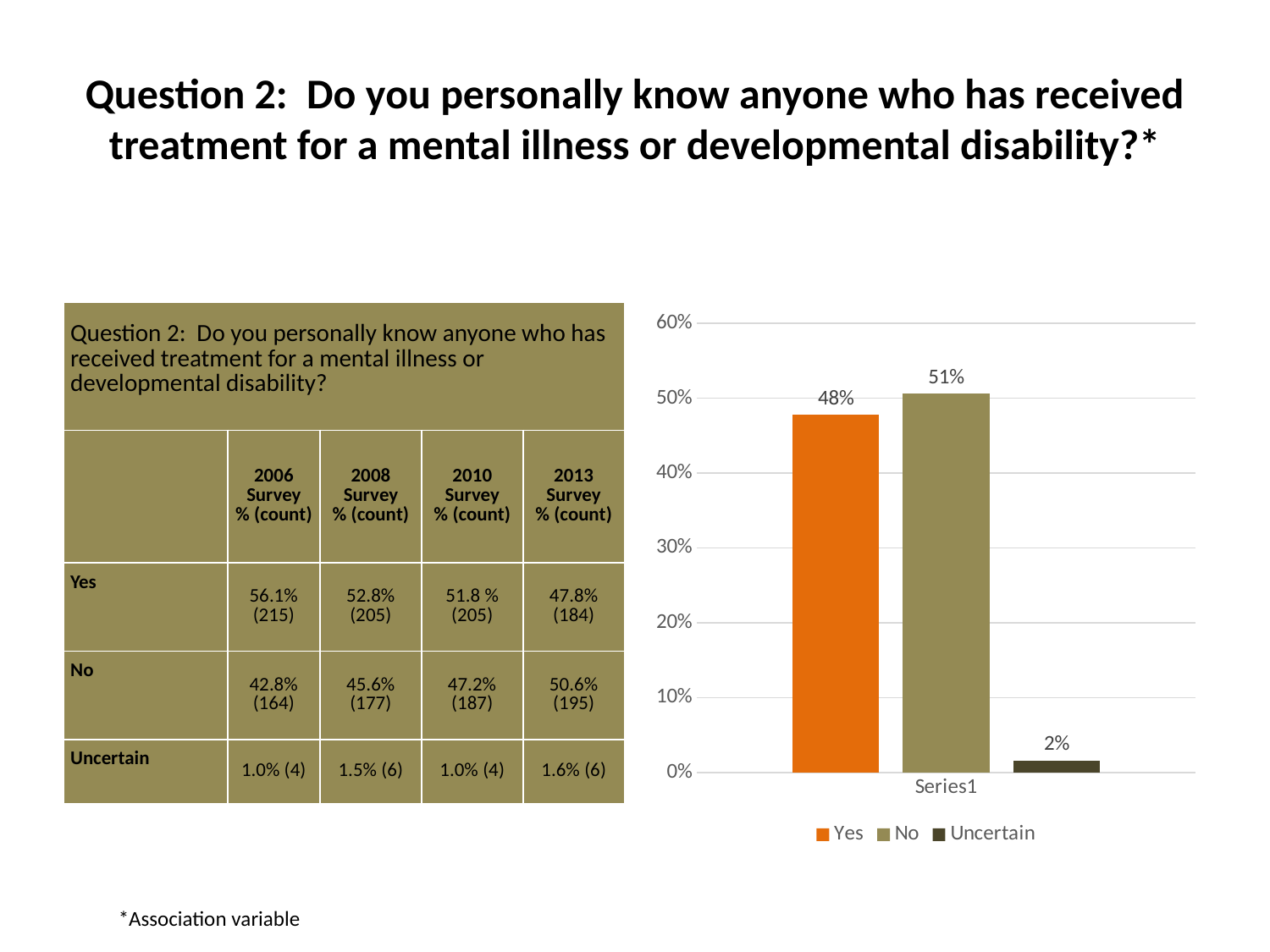
Which series has the highest value in the chart? No Which is larger in the chart, the value for Yes or the value for No? No What colour is the Yes bar in the chart? orange Is the value for Yes greater or less than 40%? greater What value does the chart show for Yes? 48% What is the difference between the Yes and Uncertain values in the chart? 46% What value does the chart show for Uncertain? 2% Which series has the lowest value in the chart? Uncertain How many series does the chart legend list? 3 What value does the chart show for No? 51% What is the difference between the No and Yes values in the chart? 3% What kind of chart is shown on the slide? bar chart